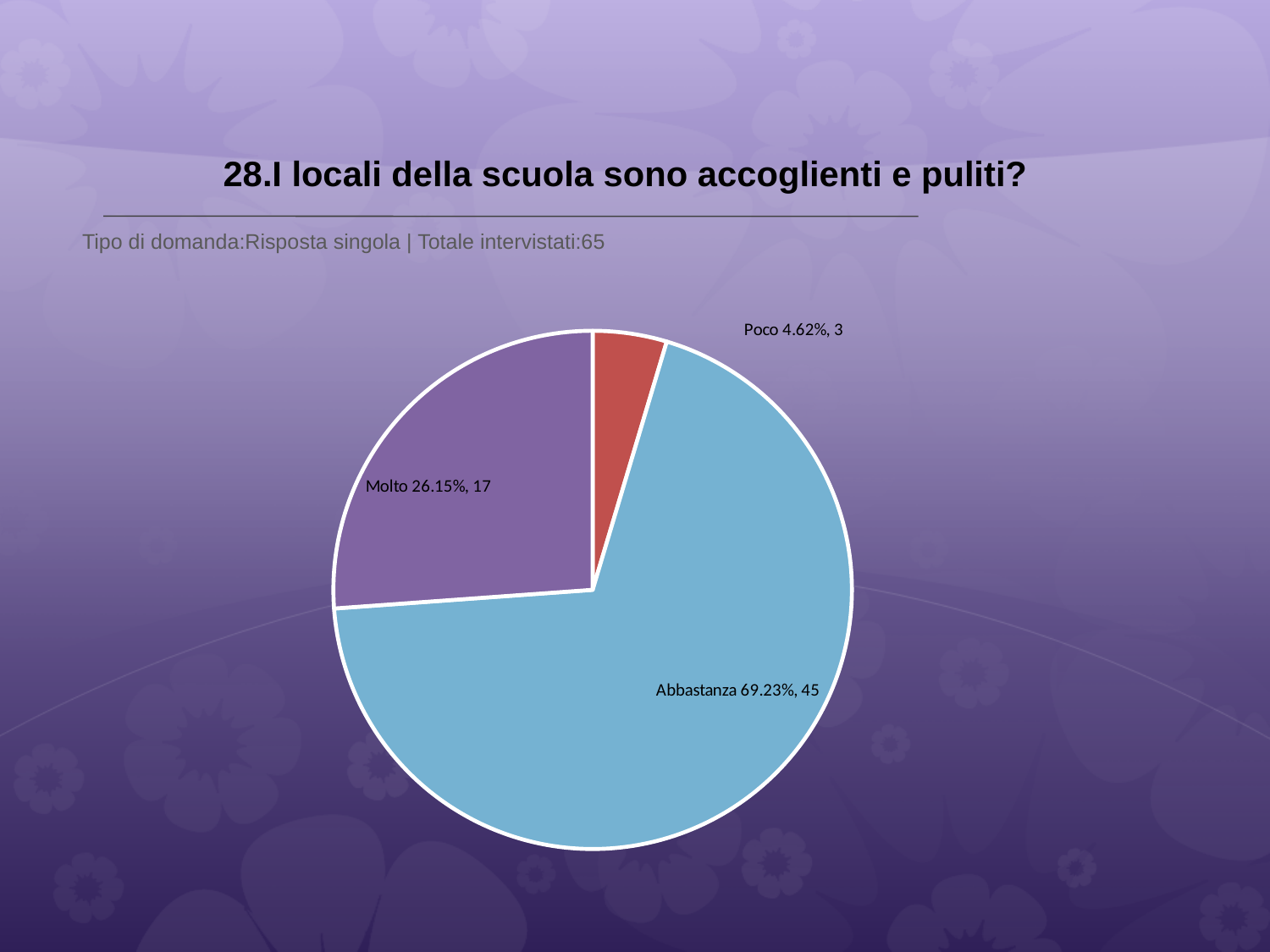
What colour is the Abbastanza slice? light blue How many slices does the pie chart have? 3 How many respondents answered Molto? 17 What kind of chart is shown on the slide? pie chart What is the difference in respondent count between Abbastanza and Molto? 28 What percentage share does the Abbastanza slice have? 69.23% What is the total number of respondents across all slices? 65 Which has more respondents, Molto or Poco? Molto Which category has the largest slice? Abbastanza Which category has the smallest slice? Poco How many respondents answered Poco? 3 What percentage share does the Poco slice have? 4.62%